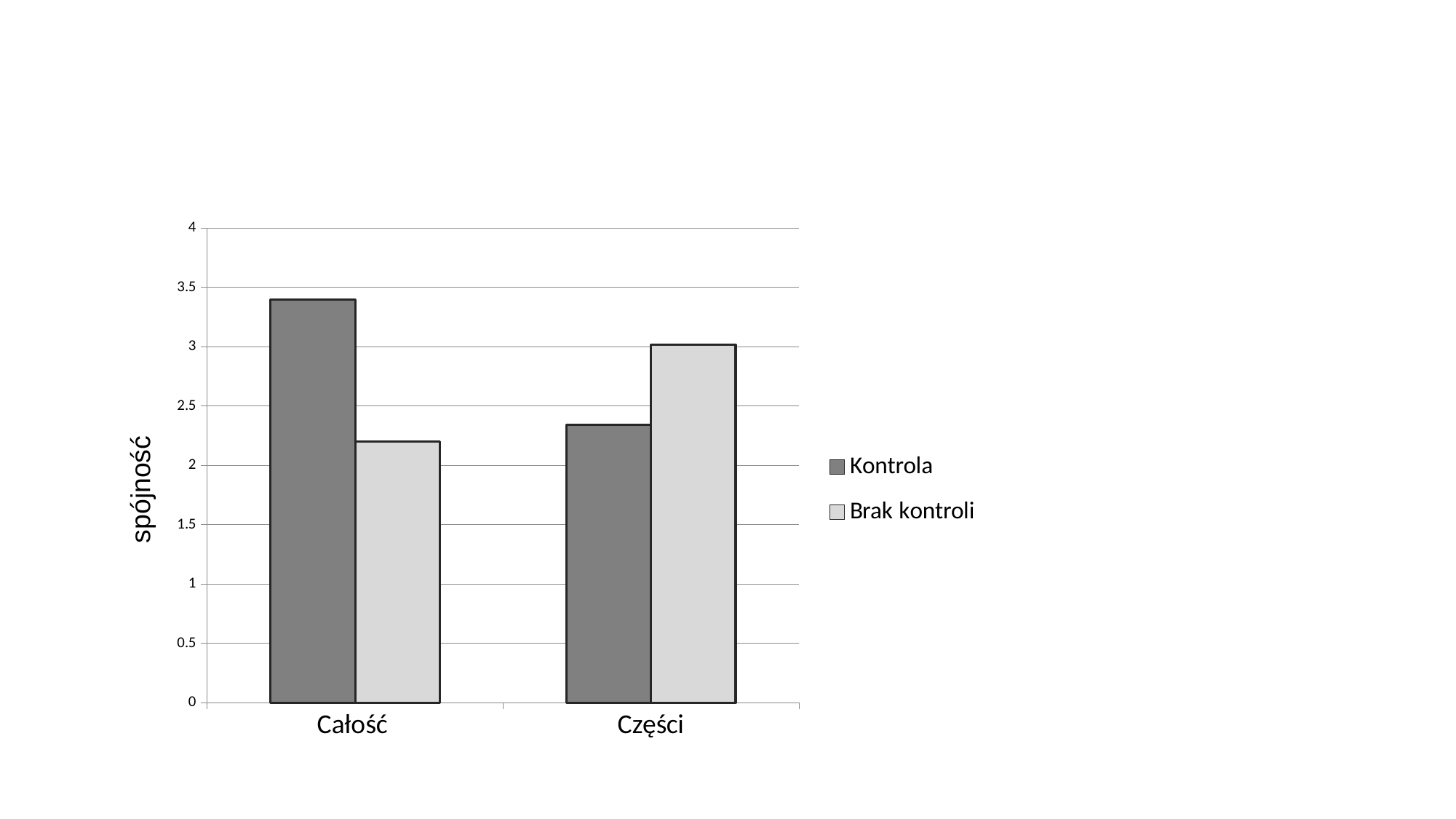
How many categories are shown on the x axis? 2 Which category has the highest Kontrola value? Całość For Części, which series has the larger value, Kontrola or Brak kontroli? Brak kontroli What kind of chart is shown on the slide? bar chart Is the Brak kontroli value for Części greater or less than 2.5? greater Is the Kontrola value for Całość greater or less than 3? greater Is the Brak kontroli value for Całość greater or less than 2.5? less For Całość, which series has the larger value, Kontrola or Brak kontroli? Kontrola What is the label of the vertical axis? spójność Which series is drawn in the darker grey? Kontrola How many series does the legend list? 2